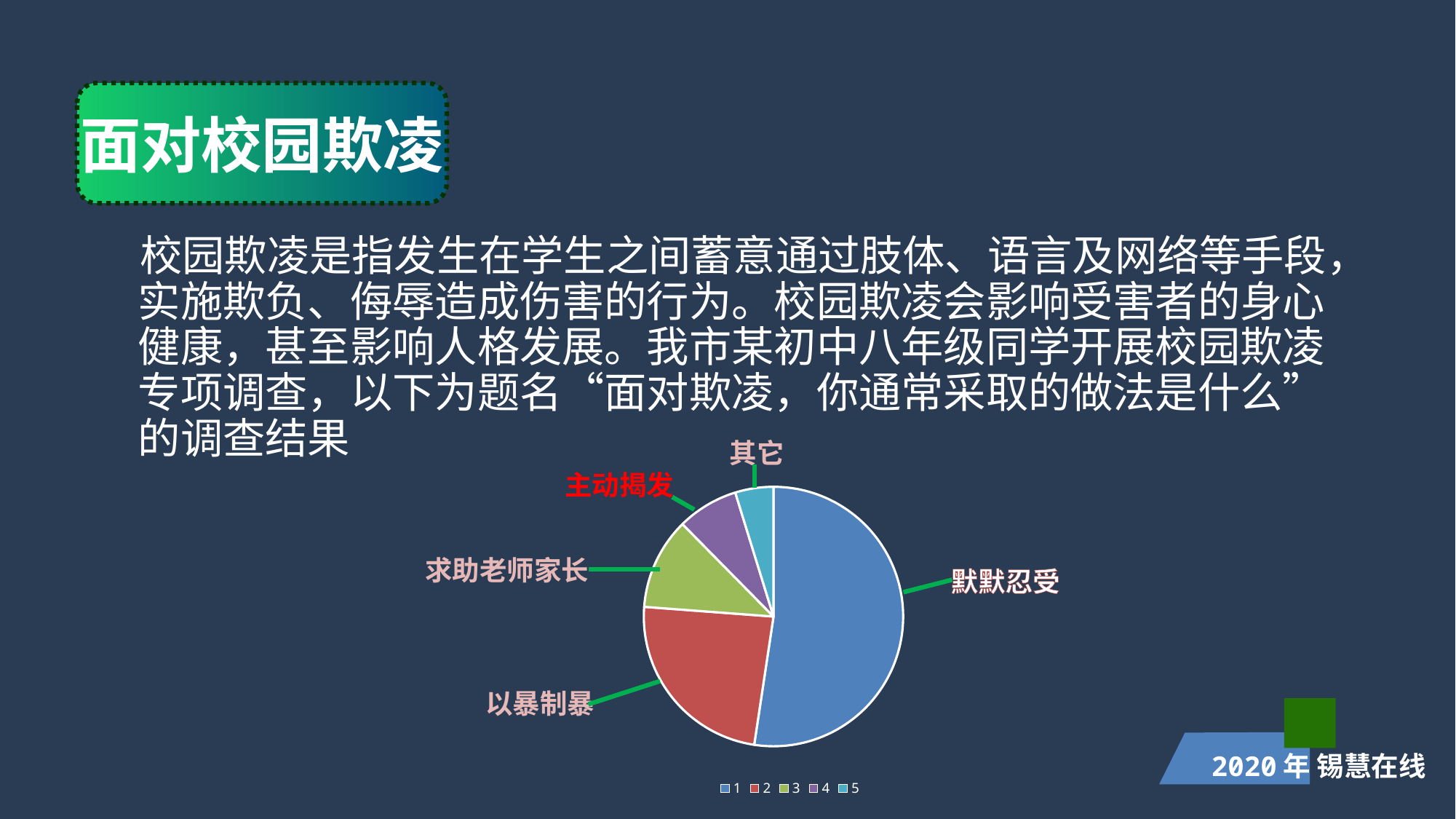
Which slice is larger, 默默忍受 or 以暴制暴? 默默忍受 Which slice is larger, 以暴制暴 or 求助老师家长? 以暴制暴 Which category has the largest slice in the pie chart? 默默忍受 How many slices does the pie chart have? 5 What colour is the slice labelled 默默忍受? blue Which slice label on the pie chart is written in red text? 主动揭发 How many entries does the legend below the pie chart list? 5 Which category has the smallest slice in the pie chart? 其它 Which slice is larger, 求助老师家长 or 主动揭发? 求助老师家长 What kind of chart is shown on the slide? pie chart